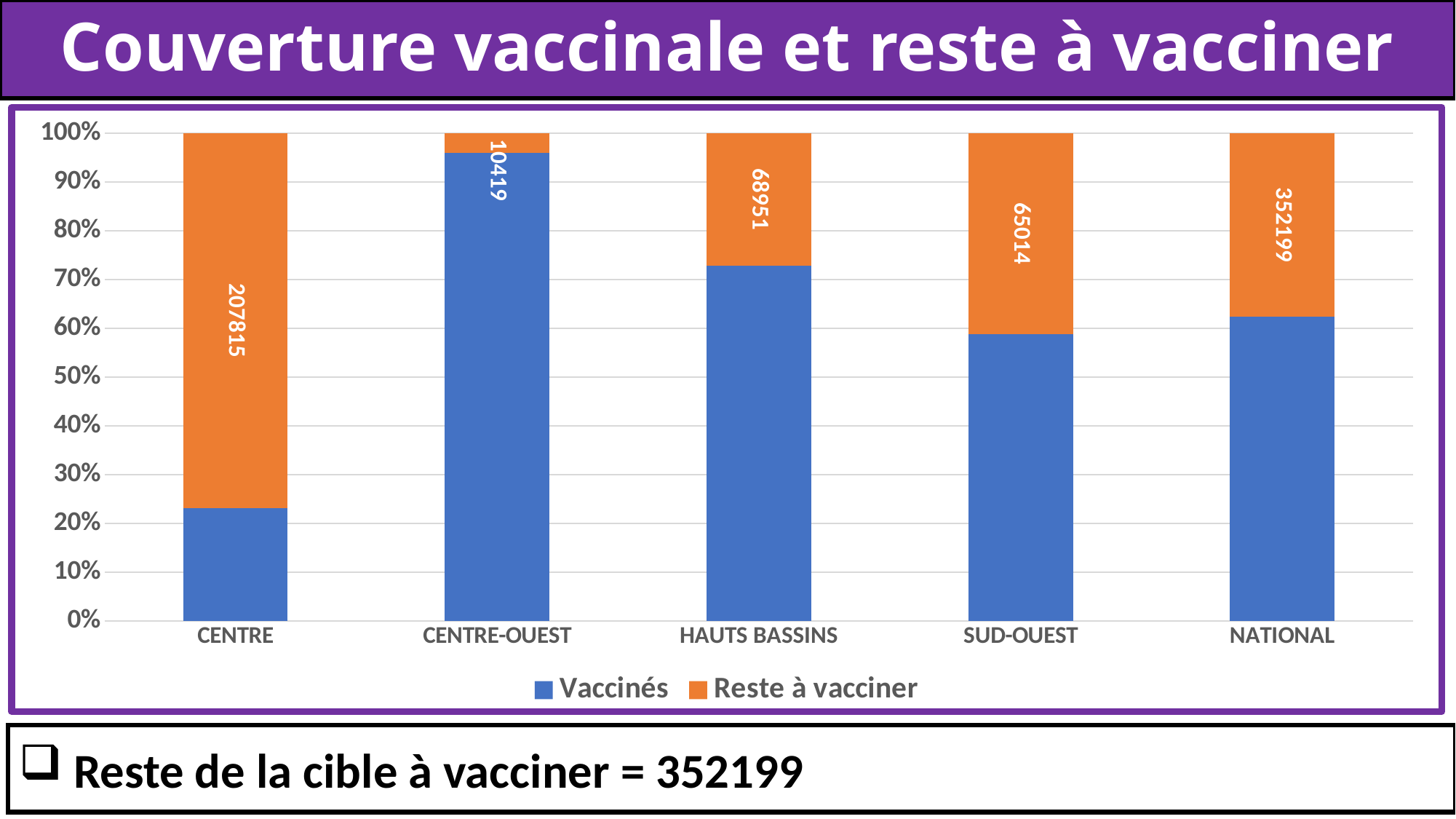
How many categories are shown on the x axis? 5 What is the 'Reste à vacciner' value for NATIONAL? 352199 Which category has the lowest 'Reste à vacciner' value? CENTRE-OUEST What is the 'Reste à vacciner' value for CENTRE-OUEST? 10419 Is the 'Vaccinés' share for CENTRE greater or less than 30%? less What is the 'Reste à vacciner' value for CENTRE? 207815 What kind of chart is shown on the slide? Stacked bar chart How many series does the legend list? 2 Is the 'Vaccinés' share for CENTRE-OUEST greater or less than 90%? greater What is the difference between the 'Reste à vacciner' values for CENTRE and CENTRE-OUEST? 197396 Among the regions CENTRE, CENTRE-OUEST, HAUTS BASSINS and SUD-OUEST, which has the highest 'Reste à vacciner' value? CENTRE Which has a larger 'Reste à vacciner' value, HAUTS BASSINS or SUD-OUEST? HAUTS BASSINS